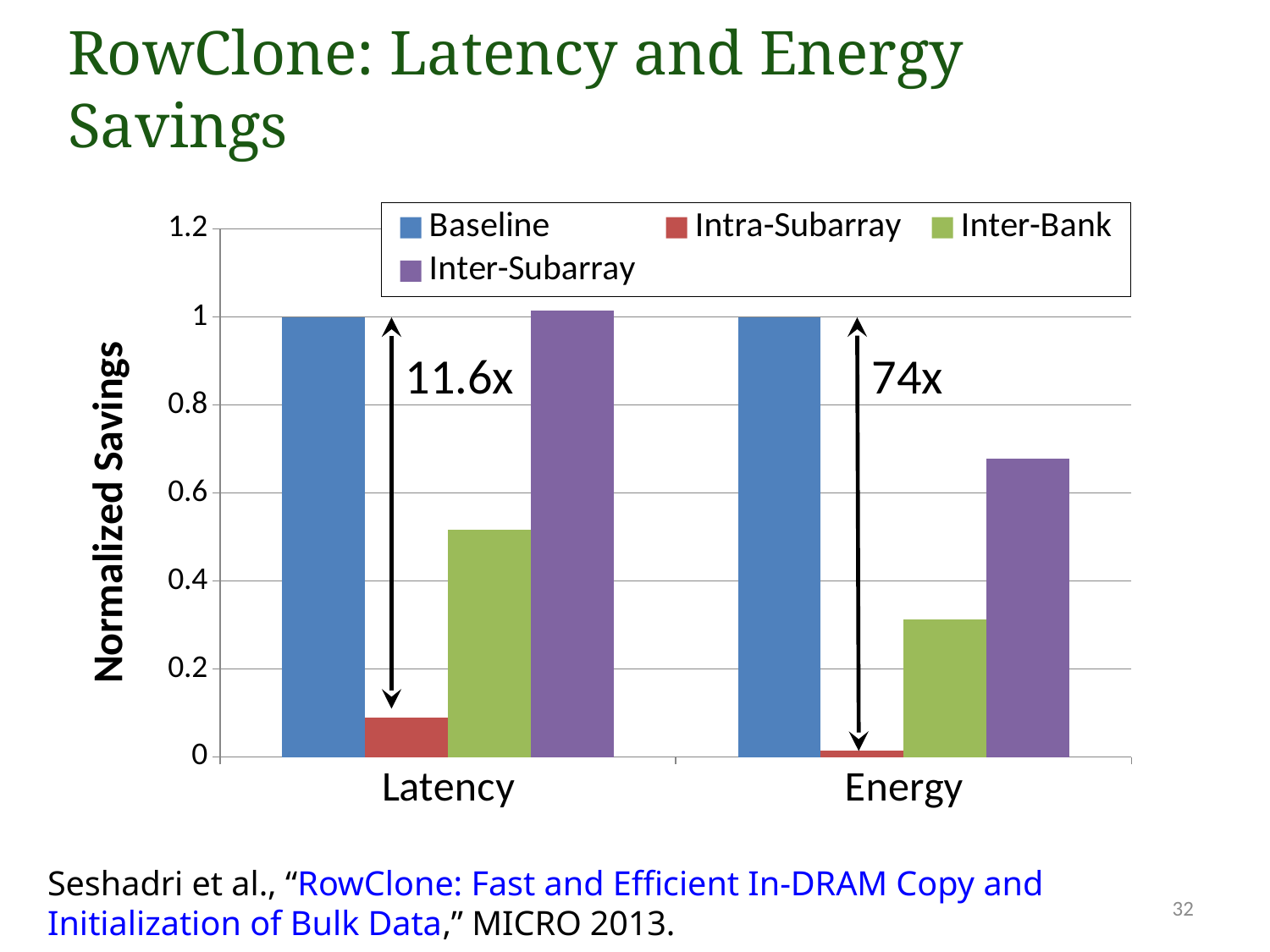
Which series has the lowest value for Energy? Intra-Subarray Is the Inter-Bank value for Latency larger or the Inter-Bank value for Energy? Latency How many series does the legend list? 4 Is the Inter-Bank value for Latency greater or less than 0.4? greater What improvement factor is annotated above the Energy bars? 74x Is the Inter-Subarray value for Energy greater or less than 0.6? greater What is the Baseline value for Energy? 1 What kind of chart is shown on the slide? bar chart Which series has the lowest value for Latency? Intra-Subarray How many categories are shown on the x axis? 2 Which series has the highest value for Energy? Baseline What is the Baseline value for Latency? 1